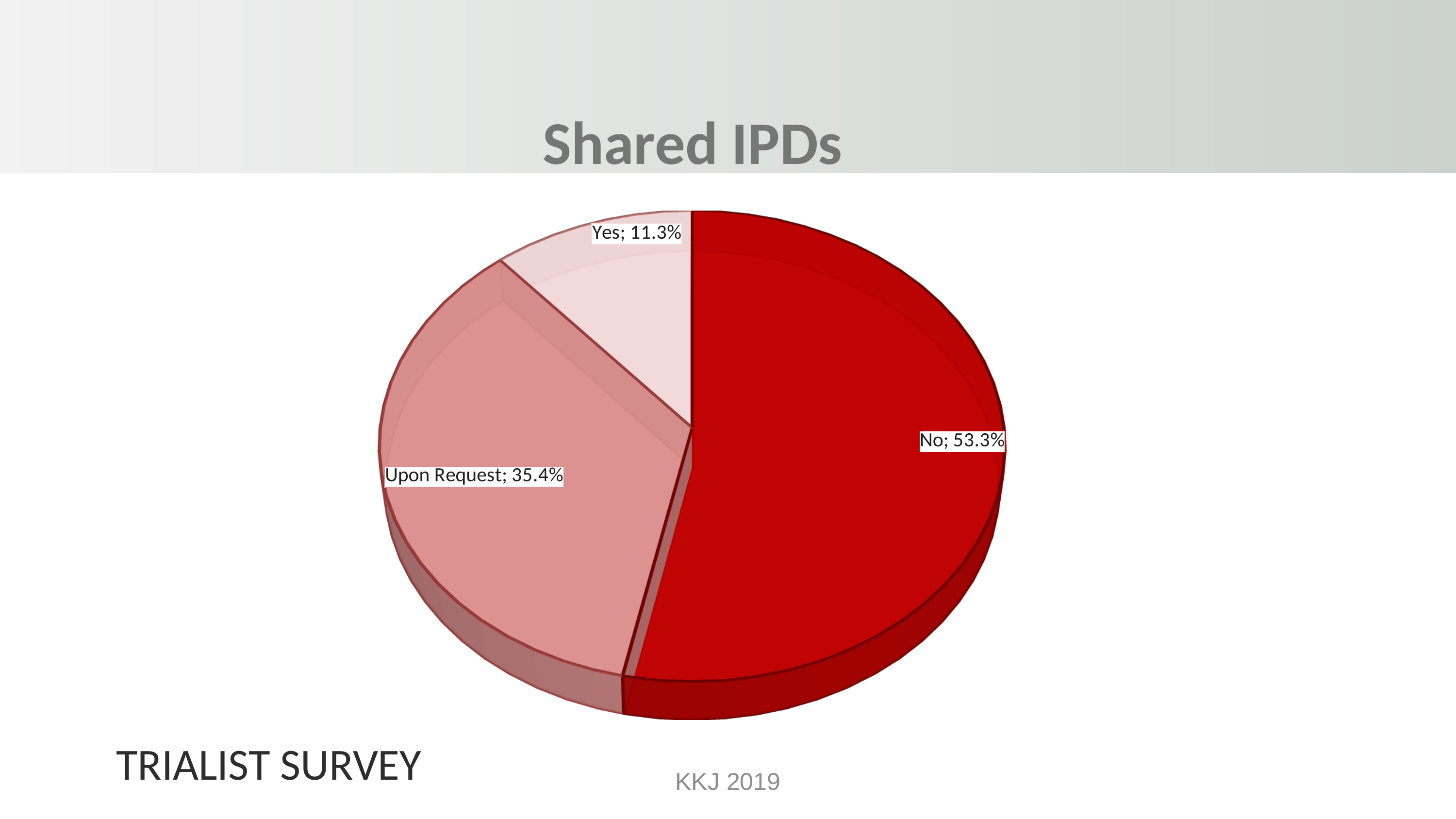
What percentage of the pie is labelled "Yes"? 11.3% What percentage of the pie is labelled "No"? 53.3% Which slice of the pie is the largest? No What percentage of the pie is labelled "Upon Request"? 35.4% Which is larger, the "Upon Request" slice or the "Yes" slice? Upon Request How many slices does the pie chart have? 3 What kind of chart is shown on the slide? Pie chart Which slice of the pie is shown in the darkest red colour? No What is the difference in percentage points between the "Upon Request" slice and the "Yes" slice? 24.1 Which slice of the pie is the smallest? Yes What is the title of the chart? Shared IPDs What is the difference in percentage points between the "No" slice and the "Upon Request" slice? 17.9